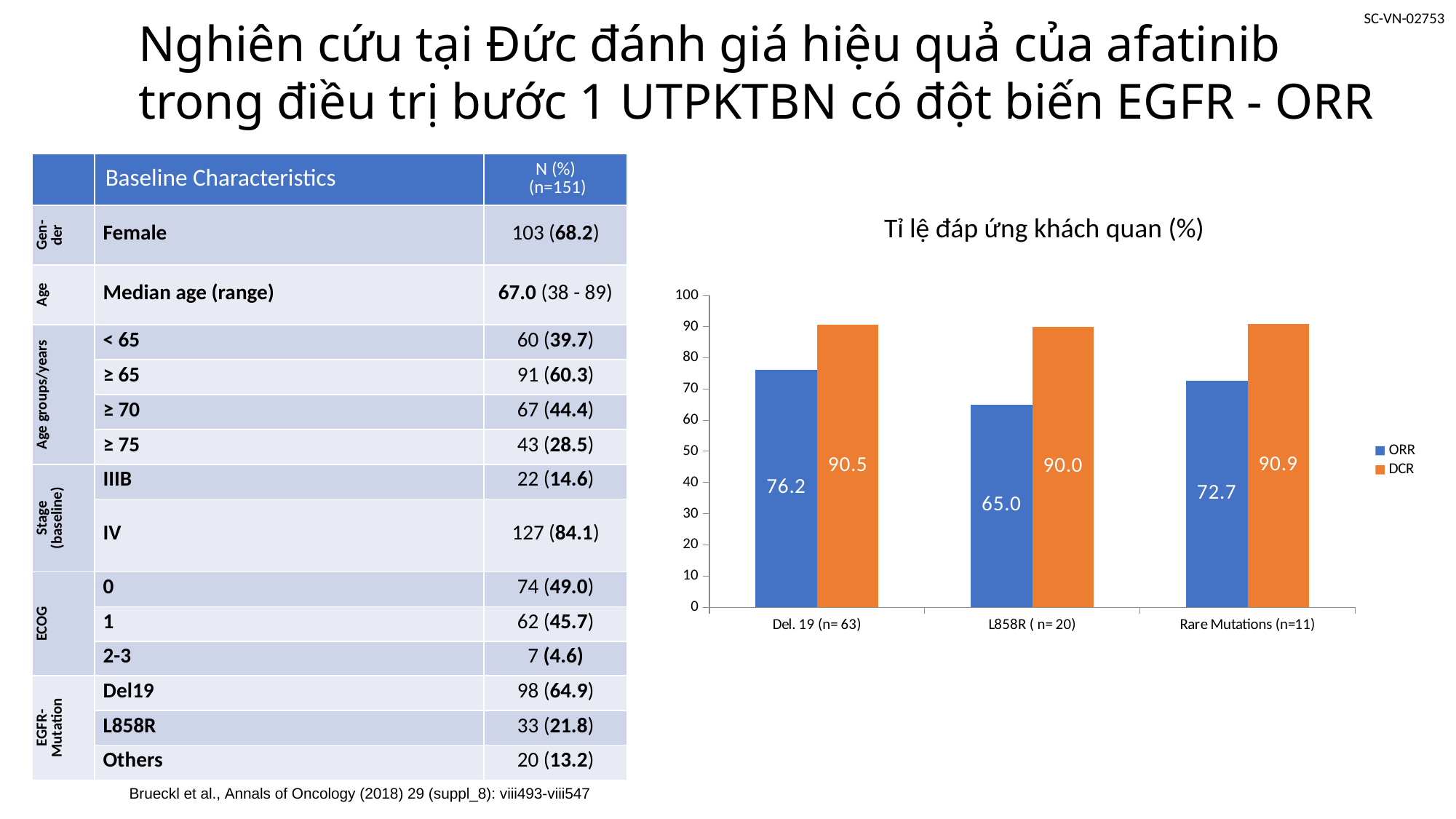
How many categories are shown on the x axis of the chart? 3 How many series does the chart legend list? 2 What kind of chart is shown on the slide? bar chart What is the difference between the DCR and ORR values for L858R ( n= 20)? 25.0 What is the ORR value for Del. 19 (n= 63)? 76.2 Which category has the highest ORR value? Del. 19 (n= 63) Which is larger, the ORR value for Del. 19 (n= 63) or the ORR value for L858R ( n= 20)? Del. 19 (n= 63) What is the DCR value for L858R ( n= 20)? 90.0 Is the ORR value for L858R ( n= 20) greater or less than 70? less What is the difference between the ORR values for Del. 19 (n= 63) and Rare Mutations (n=11)? 3.5 What is the ORR value for Rare Mutations (n=11)? 72.7 Which category has the lowest ORR value? L858R ( n= 20)